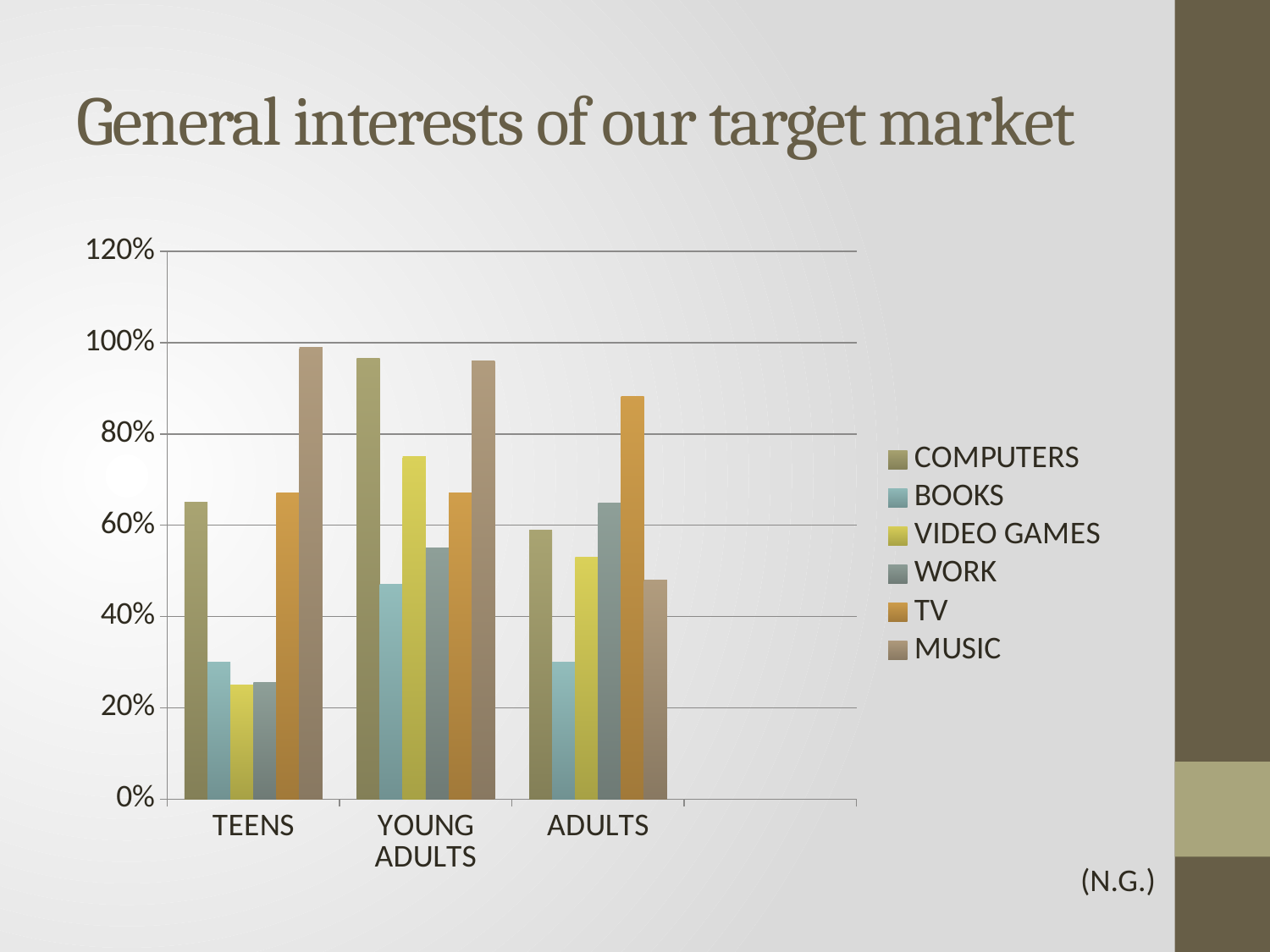
How many series does the legend list? 6 Is the value for VIDEO GAMES among YOUNG ADULTS greater or less than 60%? greater What kind of chart is shown on the slide? bar chart Which is larger, the TV value for ADULTS or the TV value for TEENS? ADULTS What is the title of the chart slide? General interests of our target market Which series has the highest value for TEENS? MUSIC How many categories are shown on the x axis? 3 Is the value for MUSIC among TEENS greater or less than 80%? greater Which series has the lowest value for ADULTS? BOOKS Is the value for BOOKS among TEENS greater or less than 40%? less Which series has the lowest value for YOUNG ADULTS? BOOKS Which series has the highest value for ADULTS? TV